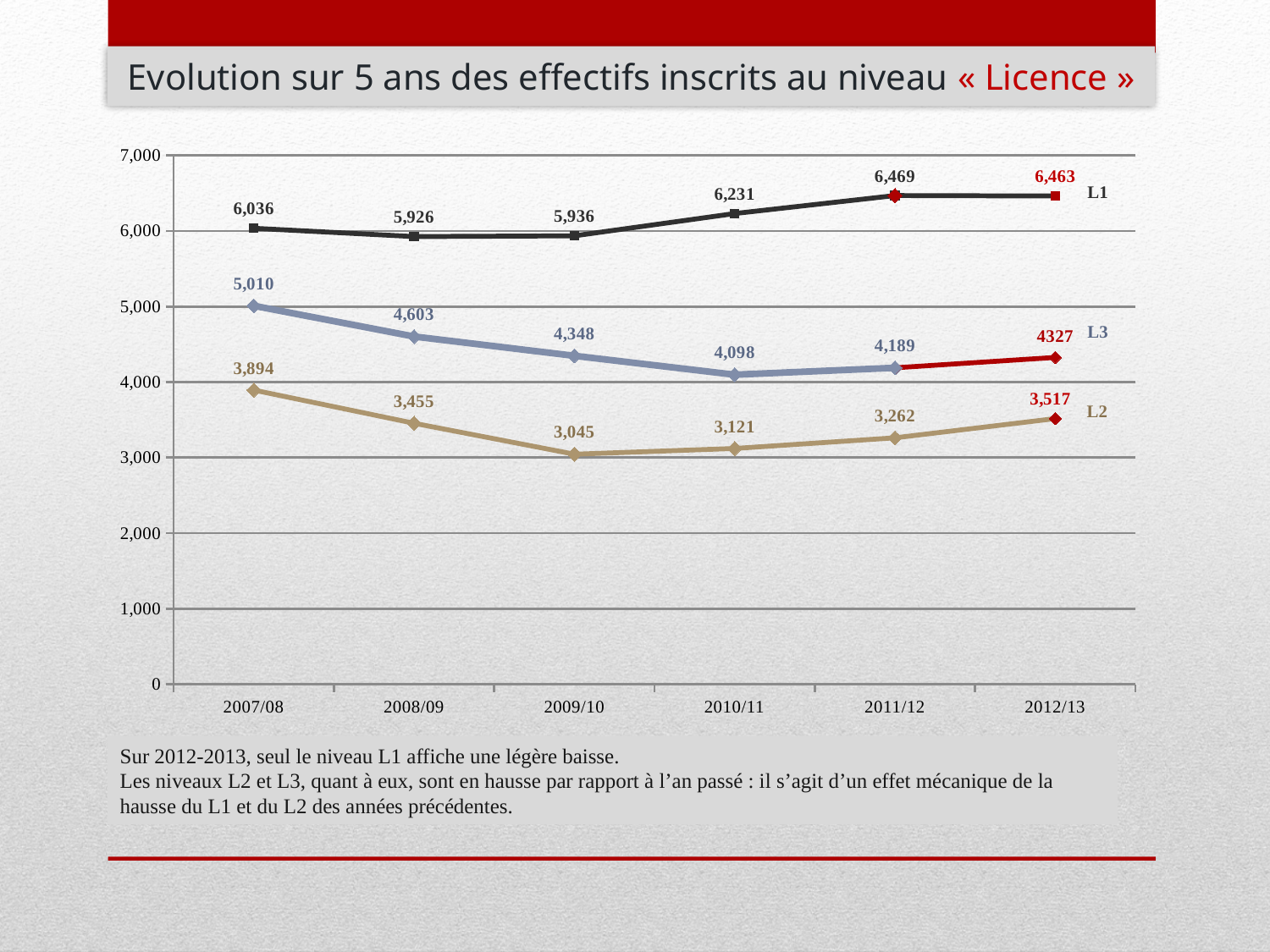
What kind of chart is shown on the slide? line chart What is the L3 value for 2009/10? 4,348 Does the L3 series rise or fall from 2007/08 to 2010/11? fall Which is larger, the L2 value for 2008/09 or the L2 value for 2011/12? 2008/09 In which year is the L2 series at its lowest? 2009/10 Is the L3 value for 2010/11 greater or less than 4,000? greater In which year is the L3 series at its highest? 2007/08 How many years are shown on the x axis? 6 What is the difference between the L3 and L2 values in 2007/08? 1,116 What is the difference between the L1 values for 2011/12 and 2012/13? 6 What is the L2 value for 2012/13? 3,517 What is the L1 value for 2011/12? 6,469